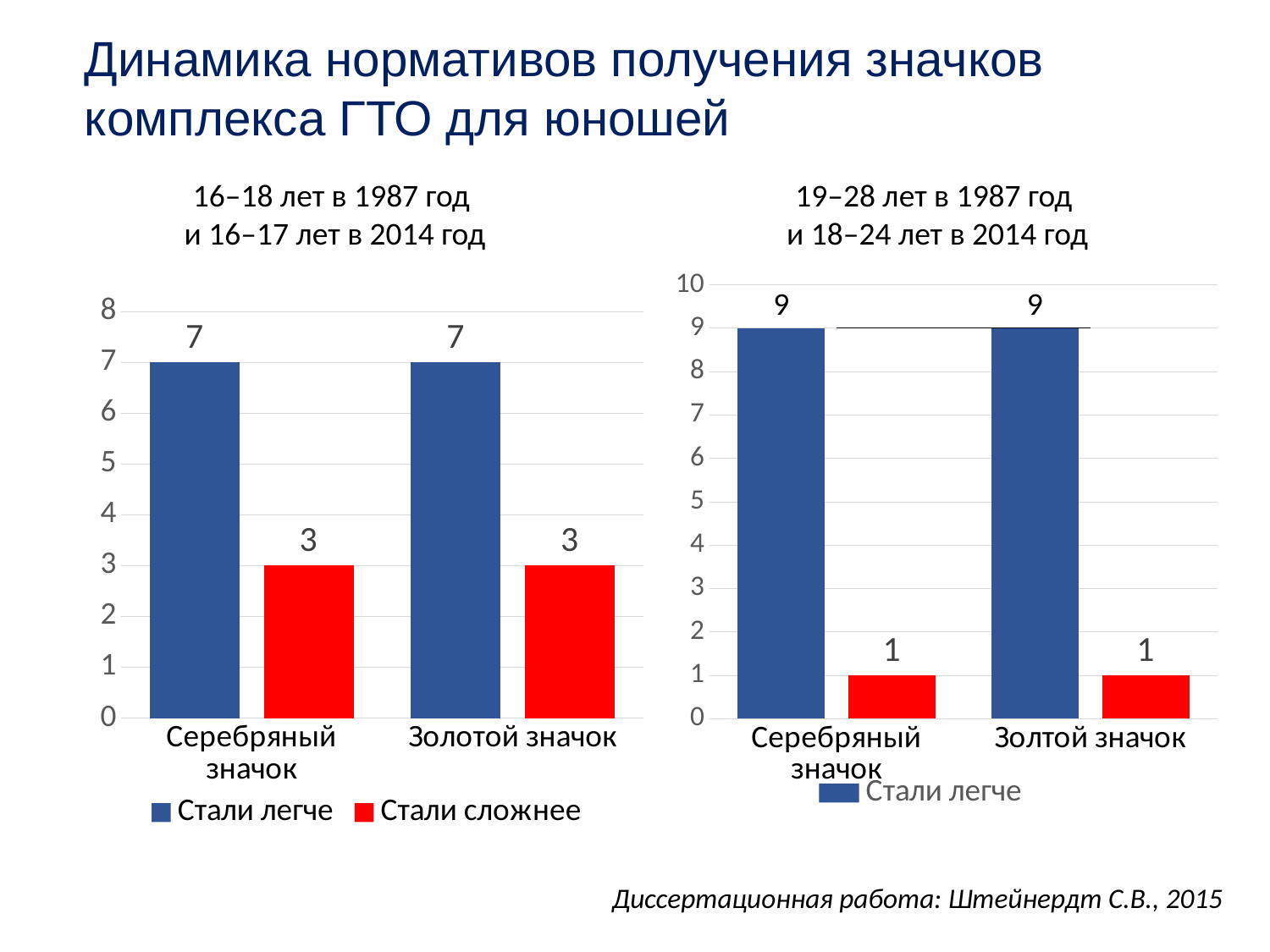
On the left chart (16–18 лет в 1987 год и 16–17 лет в 2014 год), which is larger for 'Золотой значок': 'Стали легче' or 'Стали сложнее'? Стали легче On the right chart (19–28 лет в 1987 год и 18–24 лет в 2014 год), what is the difference between the blue and red bars for 'Золтой значок'? 8 What kind of chart is the right chart (19–28 лет в 1987 год и 18–24 лет в 2014 год)? bar chart On the right chart (19–28 лет в 1987 год и 18–24 лет в 2014 год), is the value of 'Стали легче' for 'Серебряный значок' greater or less than 5? greater On the right chart (19–28 лет в 1987 год и 18–24 лет в 2014 год), what is the value of the red bar for 'Серебряный значок'? 1 How many series does the legend of the left chart (16–18 лет в 1987 год и 16–17 лет в 2014 год) list? 2 On the left chart (16–18 лет в 1987 год и 16–17 лет в 2014 год), what is the value of 'Стали легче' for 'Серебряный значок'? 7 On the left chart (16–18 лет в 1987 год и 16–17 лет в 2014 год), what is the value of 'Стали сложнее' for 'Золотой значок'? 3 On the left chart (16–18 лет в 1987 год и 16–17 лет в 2014 год), what colour are the 'Стали сложнее' bars? red On the left chart (16–18 лет в 1987 год и 16–17 лет в 2014 год), what is the difference between 'Стали легче' and 'Стали сложнее' for 'Серебряный значок'? 4 How many categories are shown on the x axis of the left chart (16–18 лет в 1987 год и 16–17 лет в 2014 год)? 2 On the right chart (19–28 лет в 1987 год и 18–24 лет в 2014 год), what is the value of 'Стали легче' for 'Золтой значок'? 9